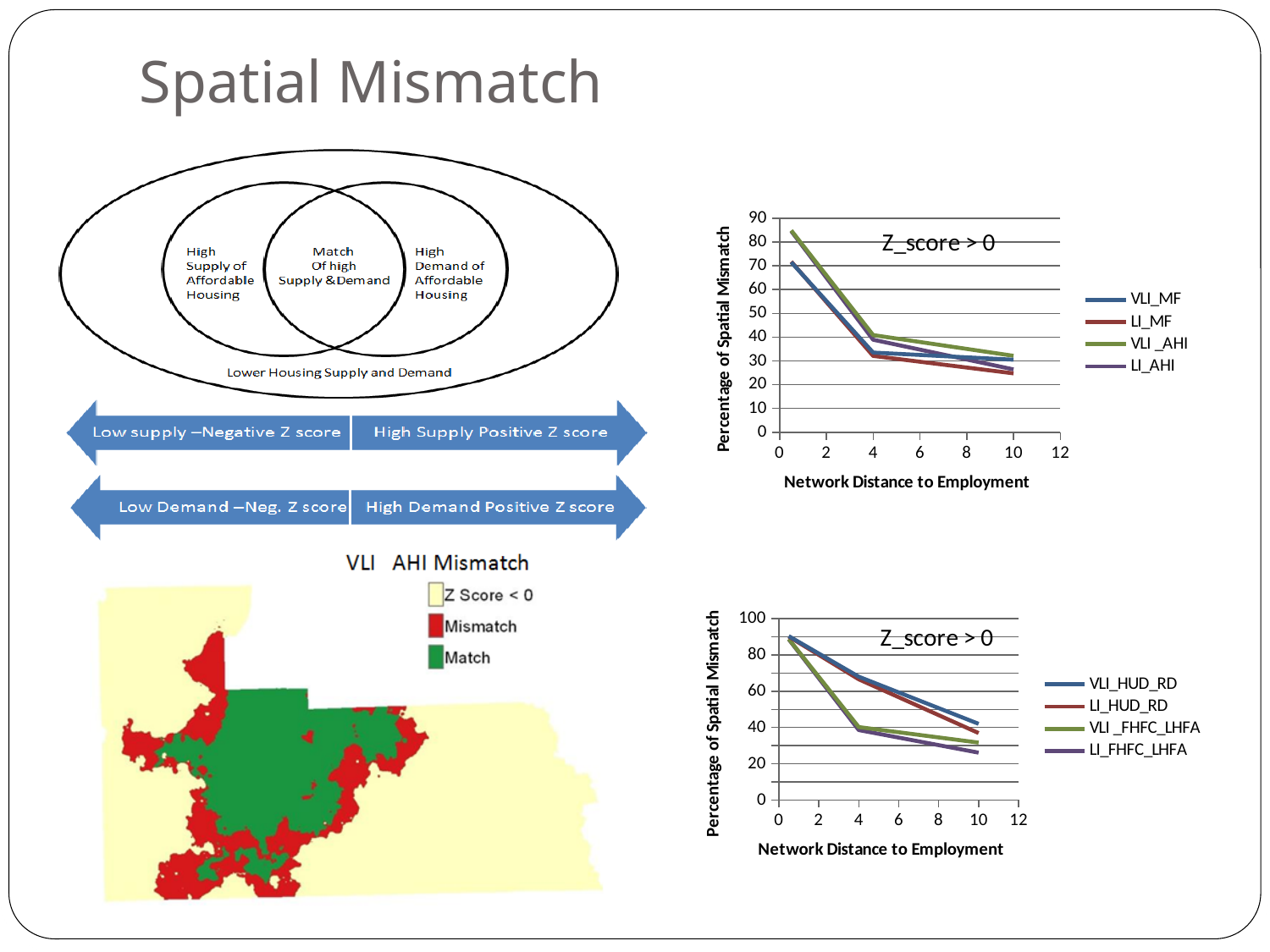
In the top-right chart, is the value for VLI _AHI at a network distance of 10 greater or less than 20? greater In the bottom-right chart, is the value for LI_FHFC_LHFA at a network distance of 10 greater or less than 40? less How many series does the legend of the top-right chart list? 4 In the bottom-right chart, which series has the lowest value at a network distance of 10? LI_FHFC_LHFA What type of chart is the top-right chart on the slide? line chart In the bottom-right chart, does the VLI_HUD_RD line rise or fall as network distance to employment increases? fall In the bottom-right chart, is the value for VLI_HUD_RD at a network distance of 4 greater or less than 60? greater In the top-right chart, does the percentage of spatial mismatch rise or fall as network distance to employment increases? fall In the bottom-right chart, which series has the highest value at a network distance of 10? VLI_HUD_RD How many series does the legend of the bottom-right chart list? 4 What is the x-axis title of the top-right chart? Network Distance to Employment